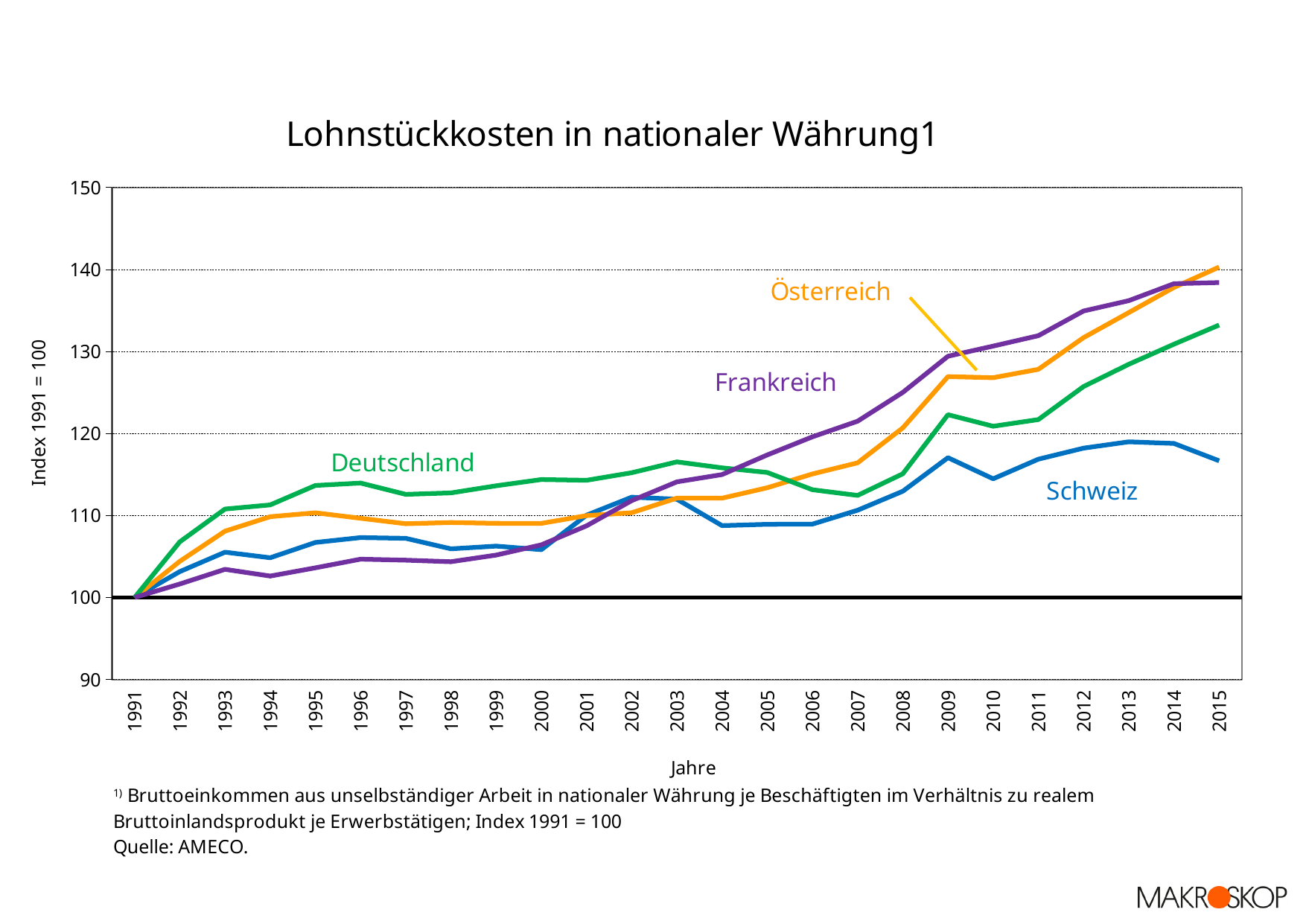
Which country has the lowest index value in 2015? Schweiz In 2009, which is larger: the value for Deutschland or the value for Schweiz? Deutschland How many years are shown along the x axis of the chart? 25 Is the value for Frankreich in 1994 greater or less than 110? less Is the value for Schweiz in 2015 greater or less than 120? less Is the value for Deutschland in 2015 greater or less than 130? greater How many series (countries) are plotted in the chart? 4 Which country has the highest index value in 1995? Deutschland Does the line for Frankreich rise or fall overall from 1991 to 2015? rise What is the index value for Deutschland in 1991? 100 What kind of chart is shown on the slide? line chart What is the title of the chart? Lohnstückkosten in nationaler Währung1